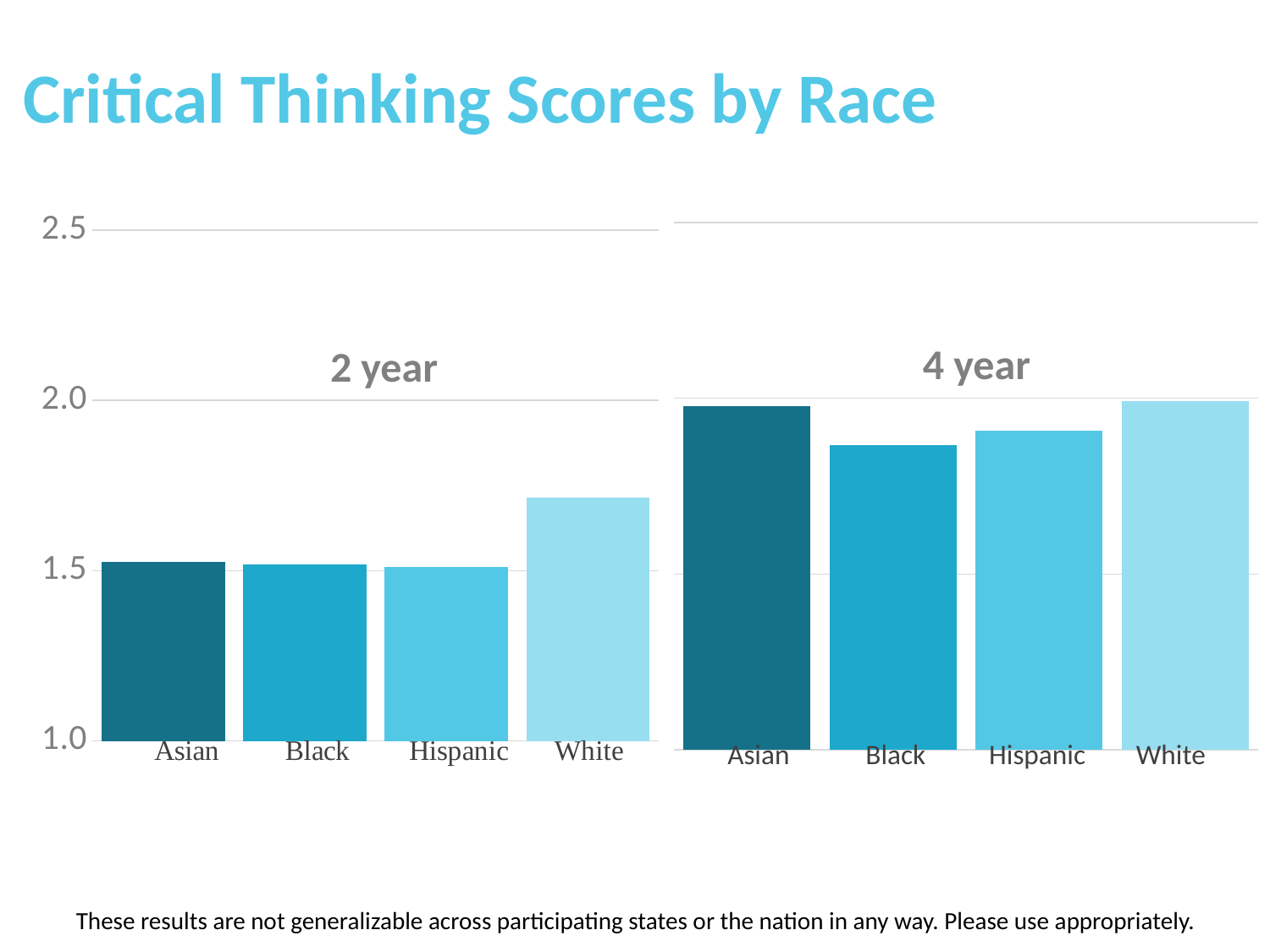
How many race categories are shown in the "4 year" chart? 4 In the "2 year" chart, is the value for Hispanic greater or less than 2.0? less How many charts are shown on the slide? 2 What kind of chart is the "2 year" chart? bar chart In the "2 year" chart, which is larger, the value for White or the value for Black? White In the "4 year" chart, is the value for Hispanic greater or less than 1.5? greater In the "4 year" chart, which is larger, the value for Asian or the value for Black? Asian In the "4 year" chart, which race has the lowest critical thinking score? Black In the "2 year" chart, which race has the highest critical thinking score? White What is the title of the slide? Critical Thinking Scores by Race In the "4 year" chart, is the value for Black greater or less than 2.0? less